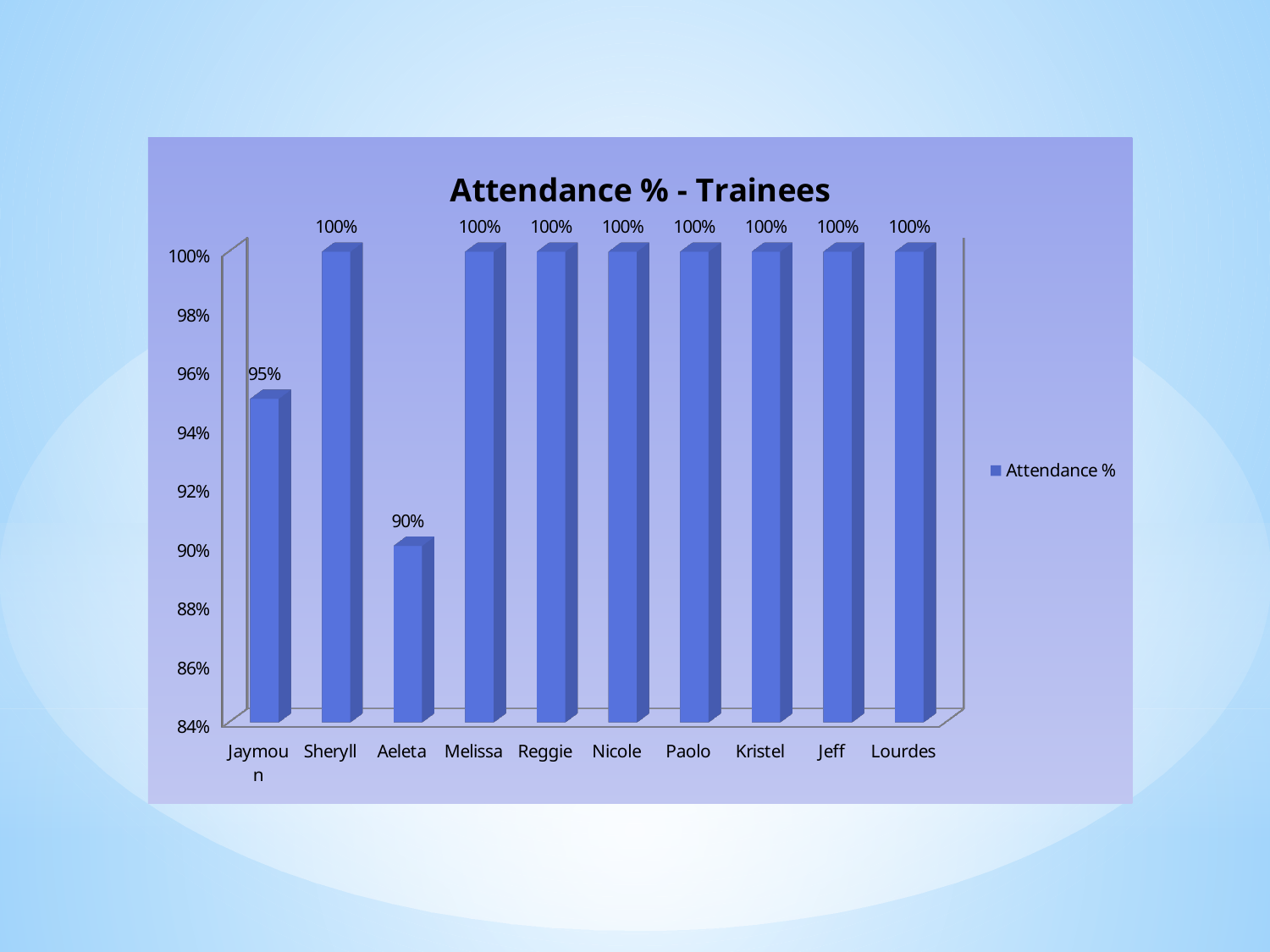
Which is larger, the attendance % for Melissa or for Jaymoun? Melissa How many trainees are shown on the chart? 10 What is the attendance % for Jaymoun? 95% What is the difference between Jaymoun's and Aeleta's attendance %? 5% What kind of chart is shown on the slide? Bar chart Which trainee has the lowest attendance %? Aeleta What is the difference between Sheryll's and Jaymoun's attendance %? 5% What is the title of the chart? Attendance % - Trainees Which is larger, the attendance % for Jaymoun or for Aeleta? Jaymoun How many series does the legend list? 1 What is the attendance % for Sheryll? 100% What is the attendance % for Aeleta? 90%